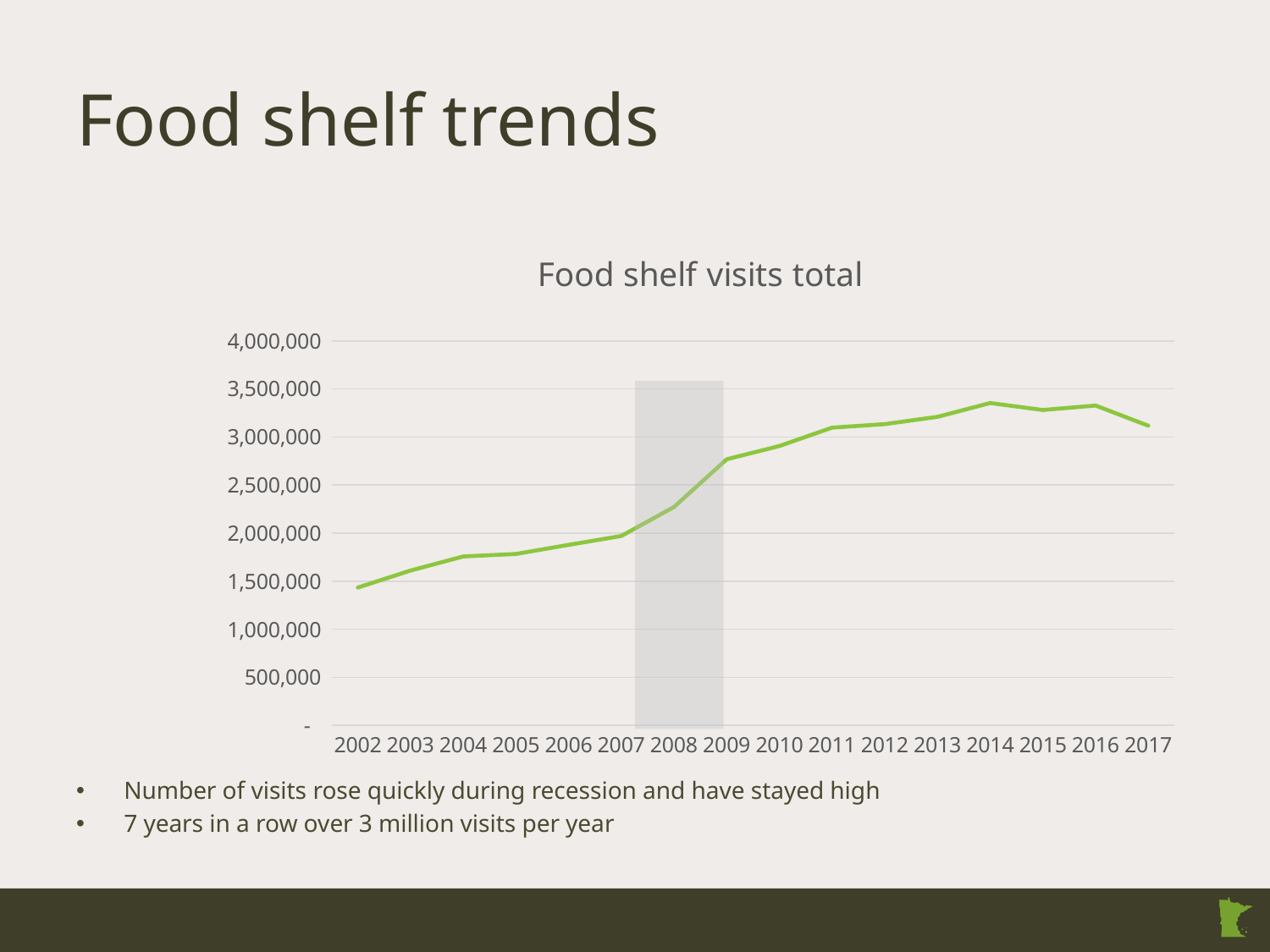
Do food shelf visits generally rise or fall from 2002 to 2014? rise Is the value for 2005 greater or less than 2,000,000? less What is the title of the chart? Food shelf visits total What kind of chart is shown on the slide? line chart Is the value for 2002 greater or less than 2,000,000? less Which year has the lowest number of food shelf visits? 2002 How many years are plotted along the x axis of the chart? 16 Which year has the larger value, 2005 or 2009? 2009 Is the value for 2014 greater or less than 3,000,000? greater Which year has the larger value, 2002 or 2017? 2017